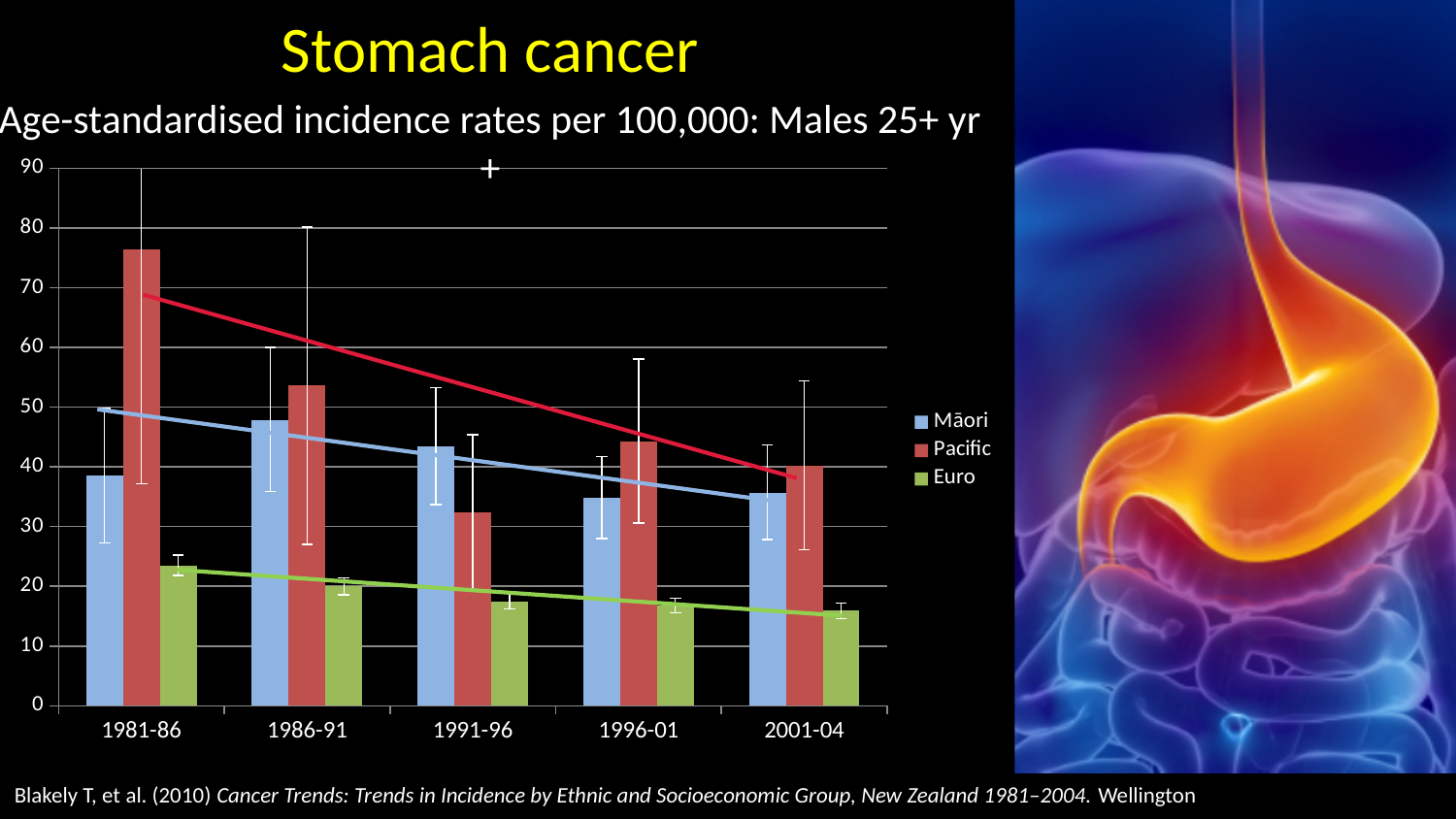
In which period is the Pacific bar lowest? 1991-96 In which period is the Pacific bar highest? 1981-86 In 1991-96, which is larger, the Māori bar or the Pacific bar? Māori How many series does the legend list? 3 Is the Pacific value for 1981-86 greater or less than 70? greater In which period is the Māori bar highest? 1986-91 What kind of chart is shown on the slide? bar chart How many time periods are shown on the x axis? 5 In 1981-86, which is larger, the Māori bar or the Pacific bar? Pacific Do the Euro values rise or fall across the periods from 1981-86 to 2001-04? fall Is the Māori value for 1986-91 greater or less than 40? greater Is the Euro value for 1981-86 greater or less than 20? greater